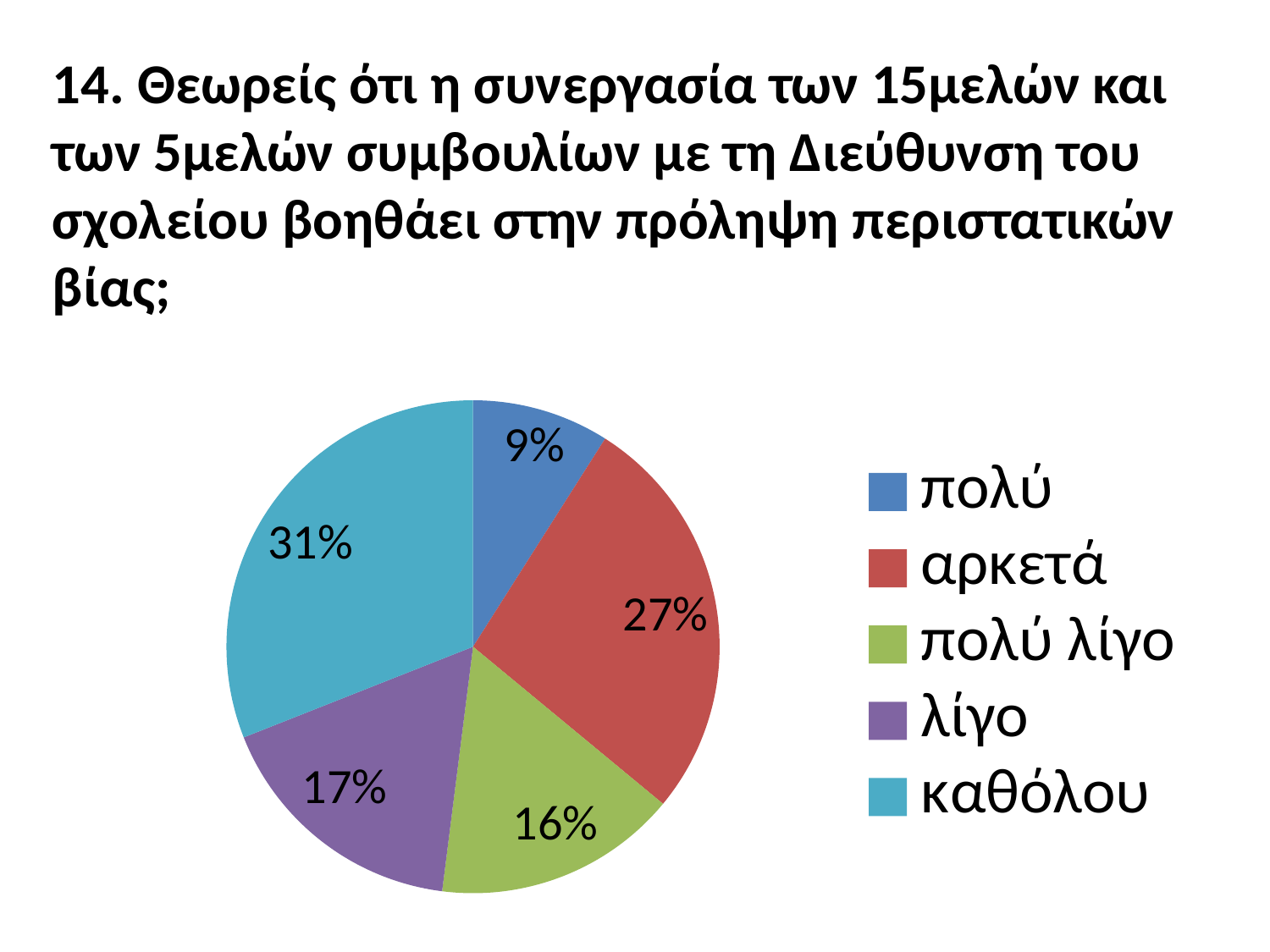
Which category has the largest slice of the pie? καθόλου How many categories does the pie chart show? 5 What percentage of the pie is the slice for πολύ λίγο? 16% Which category has the smallest slice of the pie? πολύ What percentage of the pie is the slice for αρκετά? 27% Which slice is larger, αρκετά or πολύ λίγο? αρκετά What is the difference in percentage points between the καθόλου slice and the αρκετά slice? 4 What percentage of the pie is the slice for λίγο? 17% What kind of chart is shown on the slide? pie chart What colour is the slice for λίγο in the pie chart? purple What percentage of the pie is the slice for καθόλου? 31% What percentage of the pie is the slice for πολύ? 9%